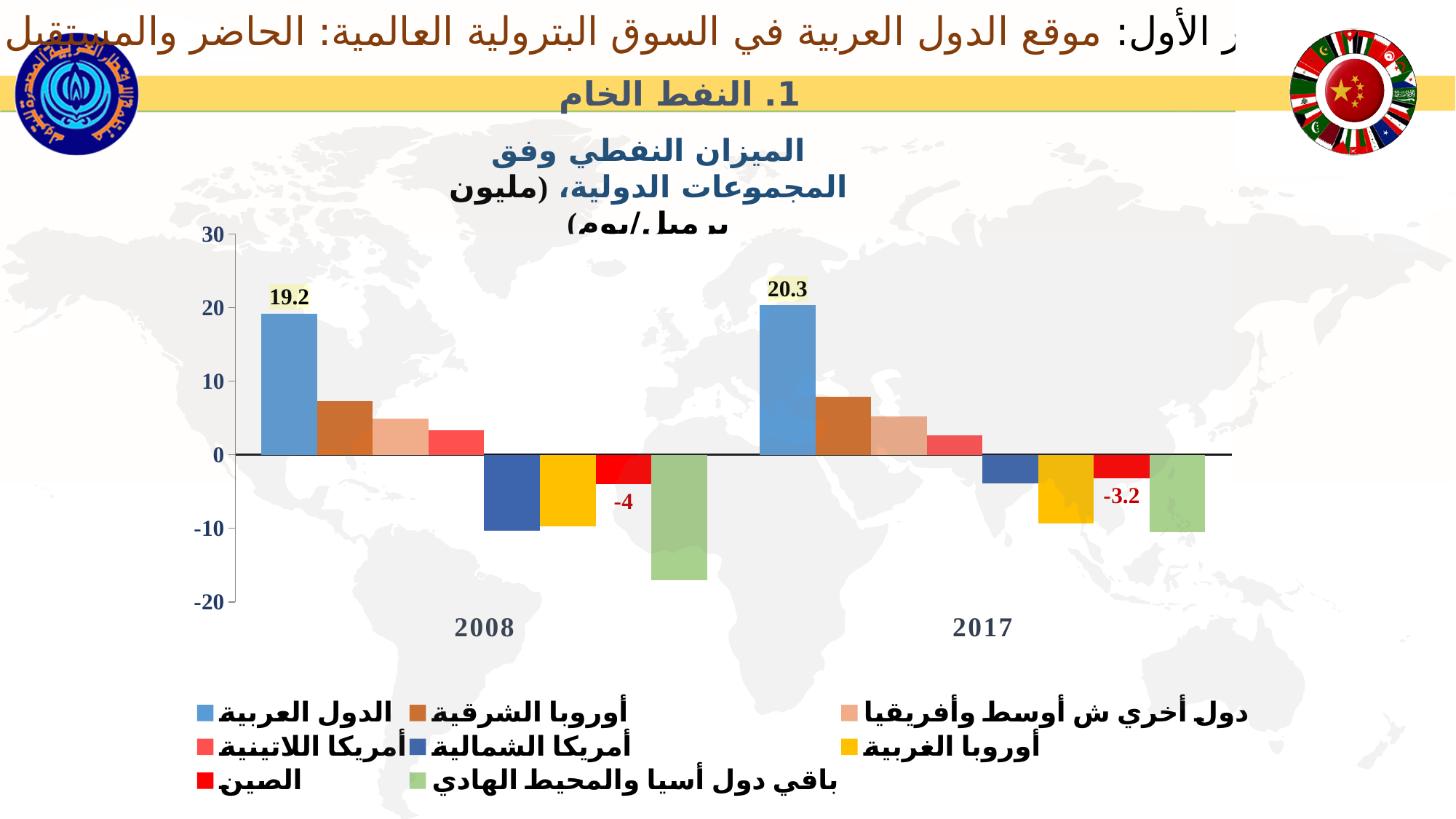
How many year categories are shown on the x axis? 2 What kind of chart is shown on the slide? bar chart What is the value for الصين in 2017? -3.2 Which series has the highest value in 2008? الدول العربية Which year has the larger value for الدول العربية, 2008 or 2017? 2017 Which series has the lowest value in 2008? باقي دول أسيا والمحيط الهادي What is the value for الصين in 2008? -4 By how much did the value for الدول العربية change from 2008 to 2017? 1.1 Is the value for باقي دول آسيا والمحيط الهادي in 2008 greater or less than -10? less What is the value for الدول العربية in 2017? 20.3 What is the value for الدول العربية in 2008? 19.2 How many series does the legend list? 8